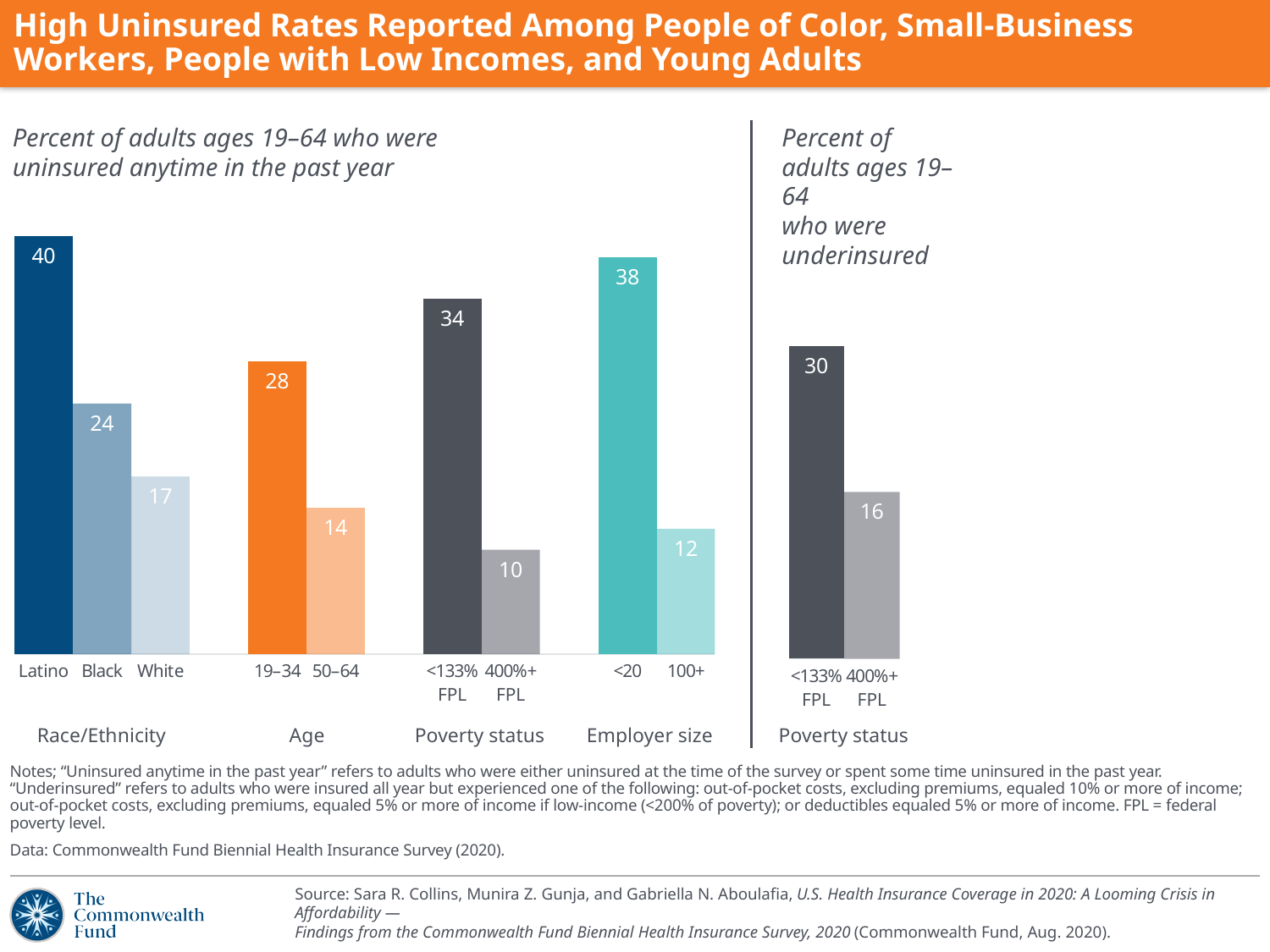
In the chart on the left (uninsured anytime in the past year), what is the value for Latino adults? 40 In the chart on the left (uninsured anytime in the past year), what is the difference between the values for Latino and White adults? 23 In the chart on the left, what are the four group labels shown beneath the bars? Race/Ethnicity, Age, Poverty status, Employer size In the chart on the left (uninsured anytime in the past year), what is the value for adults at employers with fewer than 20 workers (<20)? 38 In the chart on the left (uninsured anytime in the past year), which is larger: the value for Black adults or the value for adults ages 19–34? 19–34 How many bars are plotted in the chart on the left (uninsured anytime in the past year)? 9 What type of chart is used on the right (underinsured)? Bar chart In the chart on the left (uninsured anytime in the past year), which category has the highest value? Latino In the chart on the left (uninsured anytime in the past year), which category has the lowest value? 400%+ FPL In the chart on the left (uninsured anytime in the past year), what is the value for adults ages 19–34? 28 In the chart on the right (underinsured), what is the difference between the values for <133% FPL and 400%+ FPL? 14 In the chart on the right (underinsured), what is the value for adults below 133% FPL? 30